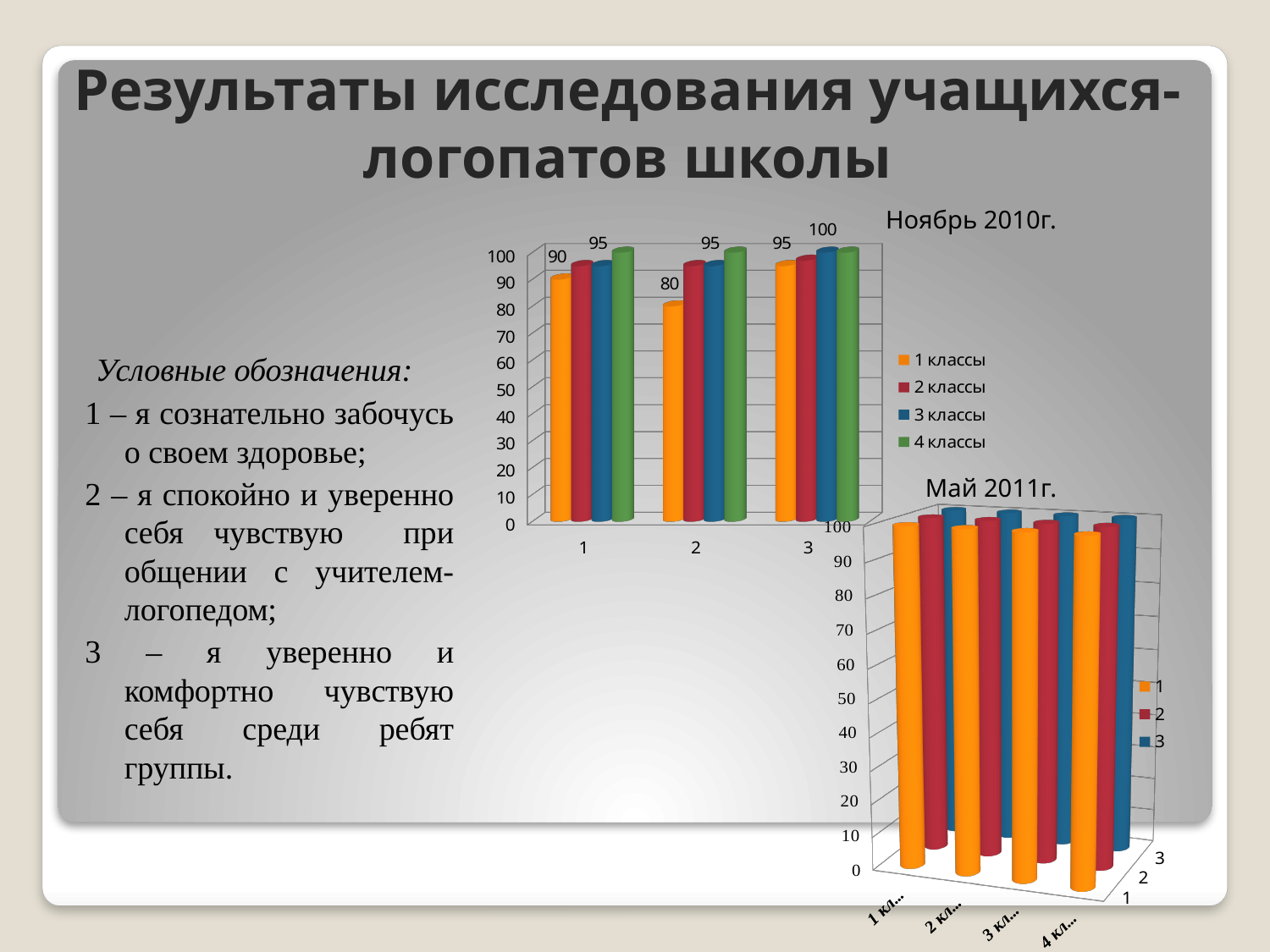
How many categories are shown along the x axis of the 'Май 2011г.' chart? 4 In the 'Ноябрь 2010г.' chart, what is the value for '1 классы' at category 3? 95 In the 'Ноябрь 2010г.' chart, what is the value for '1 классы' at category 2? 80 In the 'Ноябрь 2010г.' chart, what is the difference between the '1 классы' values at category 1 and category 2? 10 How many series does the legend of the 'Ноябрь 2010г.' chart list? 4 How many categories are shown on the x axis of the 'Ноябрь 2010г.' chart? 3 In the 'Ноябрь 2010г.' chart, is the value for '4 классы' at category 1 greater or less than 50? greater In the 'Ноябрь 2010г.' chart, what is the value for '1 классы' at category 1? 90 What kind of chart is the 'Ноябрь 2010г.' chart? bar chart In the 'Ноябрь 2010г.' chart, at which category is the '1 классы' value lowest? 2 In the 'Ноябрь 2010г.' chart, is the '1 классы' value larger at category 3 or at category 2? category 3 How many series does the legend of the 'Май 2011г.' chart list? 3